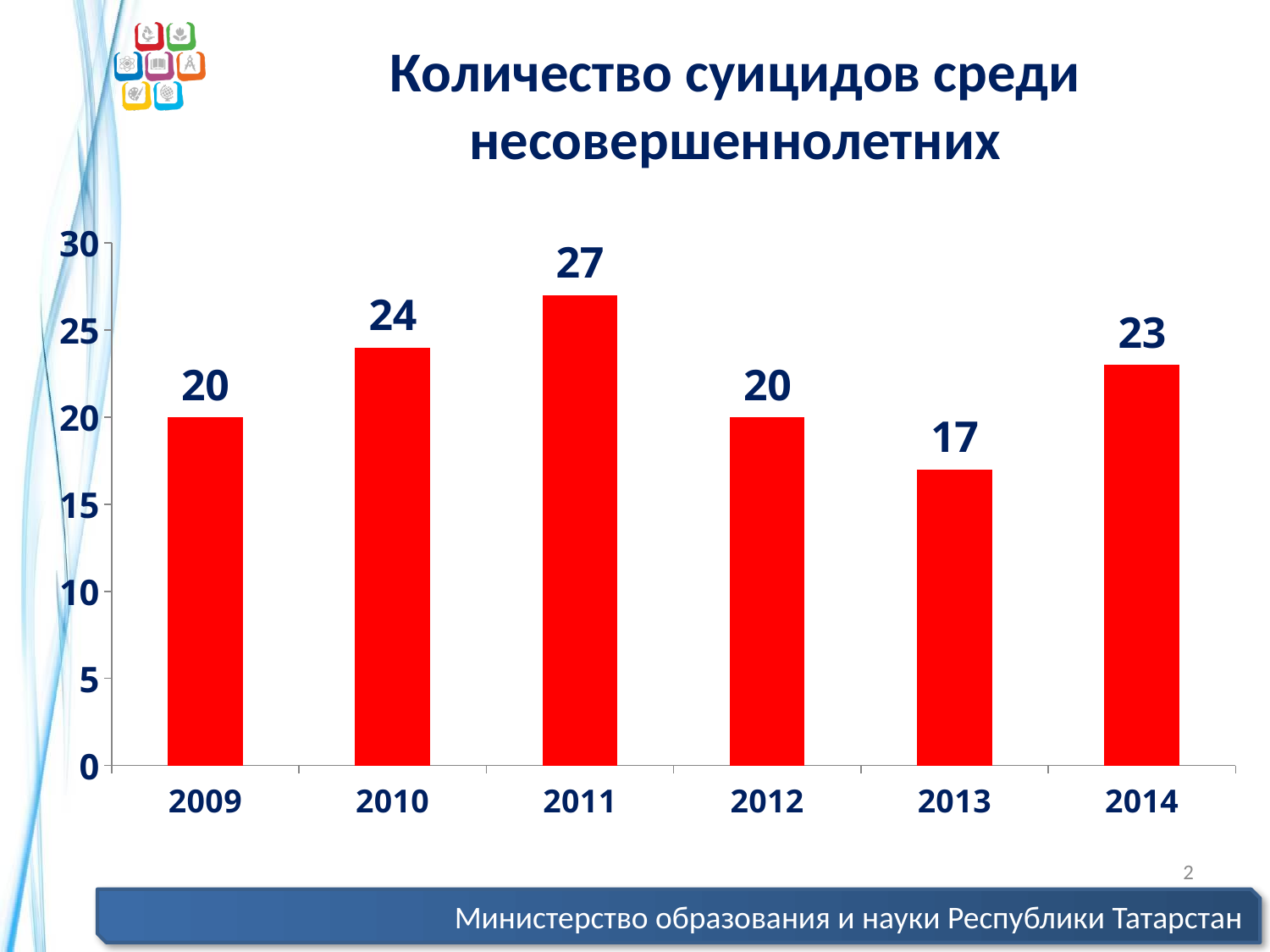
What is the difference between the values for 2011 and 2013? 10 What is the title of the chart? Количество суицидов среди несовершеннолетних What kind of chart is shown on the slide? bar chart Which year has the highest value? 2011 What is the value for 2014? 23 What is the difference between the values for 2010 and 2009? 4 What is the value for 2011? 27 Is the value for 2011 greater or less than 25? greater Which year has the lowest value? 2013 What is the value for 2013? 17 How many years are shown on the x axis? 6 Which is larger, the value for 2014 or the value for 2012? 2014